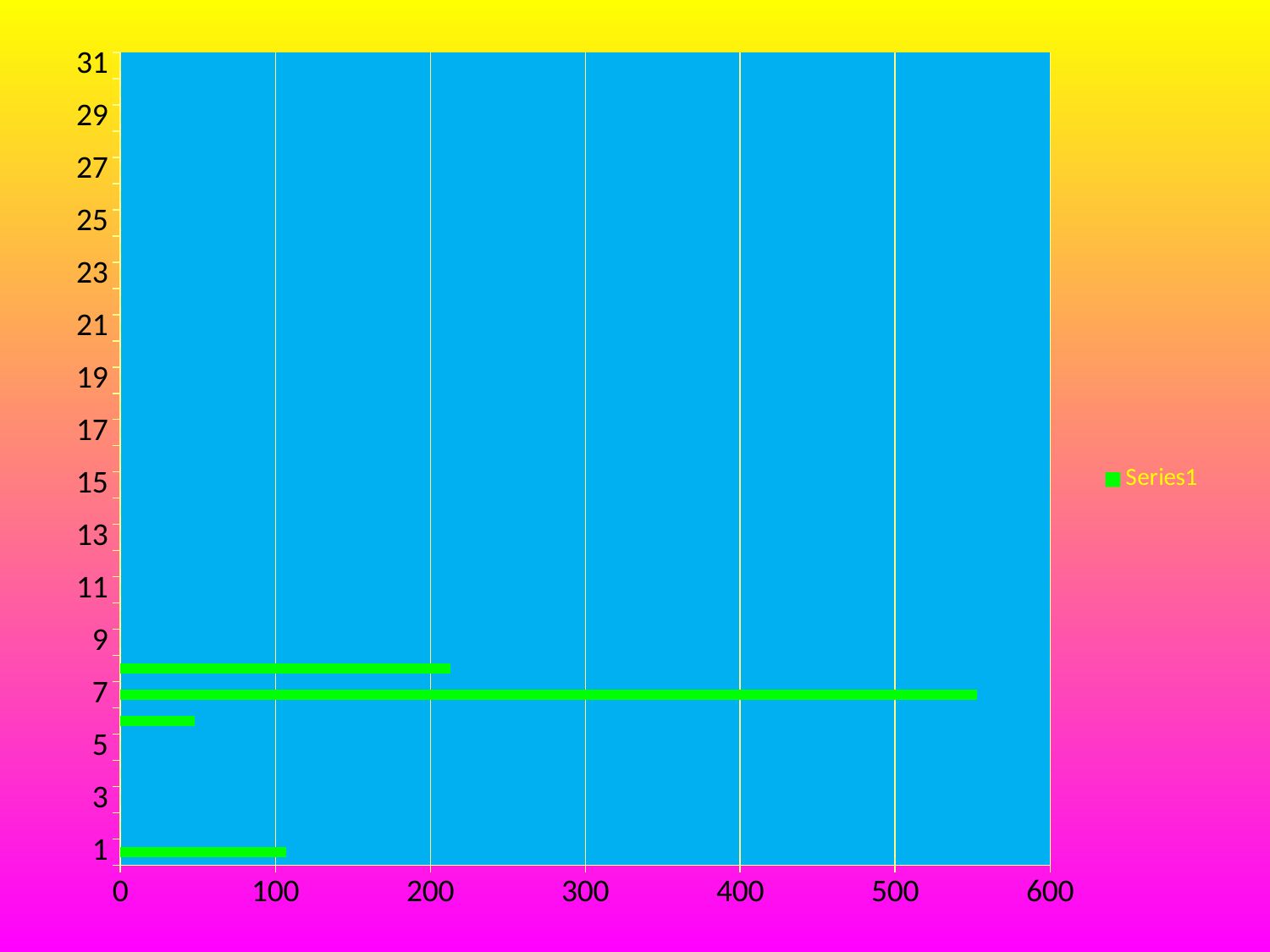
Is the value for category 7 greater or less than 500? greater How many bars are plotted on the chart? 4 What kind of chart is shown on the slide? bar chart How many series does the legend list? 1 Is the value for category 1 greater or less than 200? less Which has the larger value, category 1 or category 7? 7 Is the value for category 7 greater or less than 600? less What is the highest value shown on the horizontal axis? 600 What is the name of the series shown in the legend? Series1 What colour are the bars on the chart? green Which category has the longest bar? 7